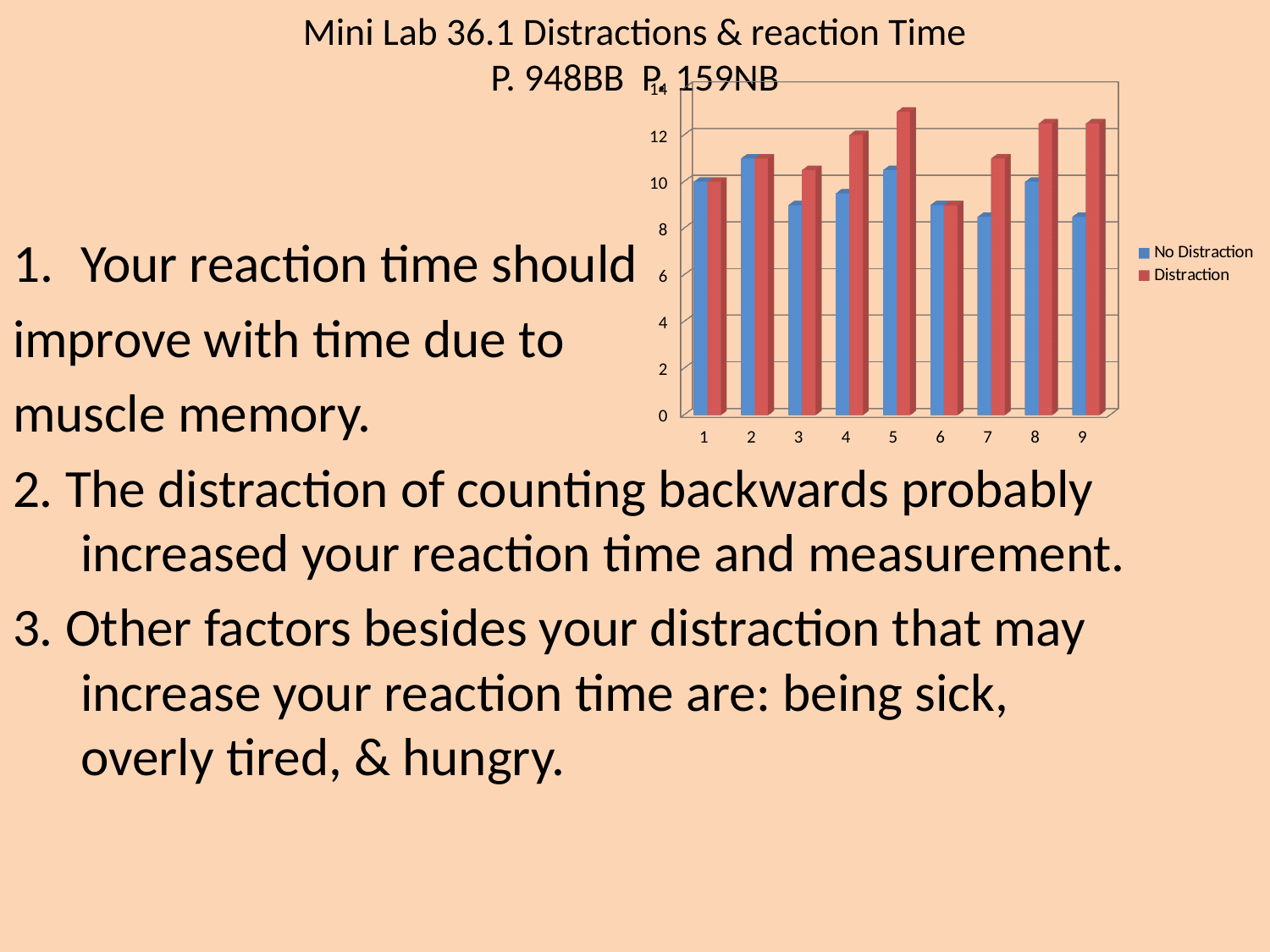
What kind of chart is shown on the slide? bar chart For category 4, which series has the larger value, No Distraction or Distraction? Distraction How many series does the chart's legend list? 2 For category 9, which series has the larger value, No Distraction or Distraction? Distraction How many categories are shown along the x axis of the chart? 9 Which category has the lowest value for the Distraction series? 6 Is the Distraction value for category 5 greater or less than 12? greater Is the No Distraction value for category 7 greater or less than 10? less Which category has the highest value for the Distraction series? 5 Which category has the highest value for the No Distraction series? 2 Is the Distraction value for category 6 greater or less than 10? less What colour are the bars for the Distraction series? red